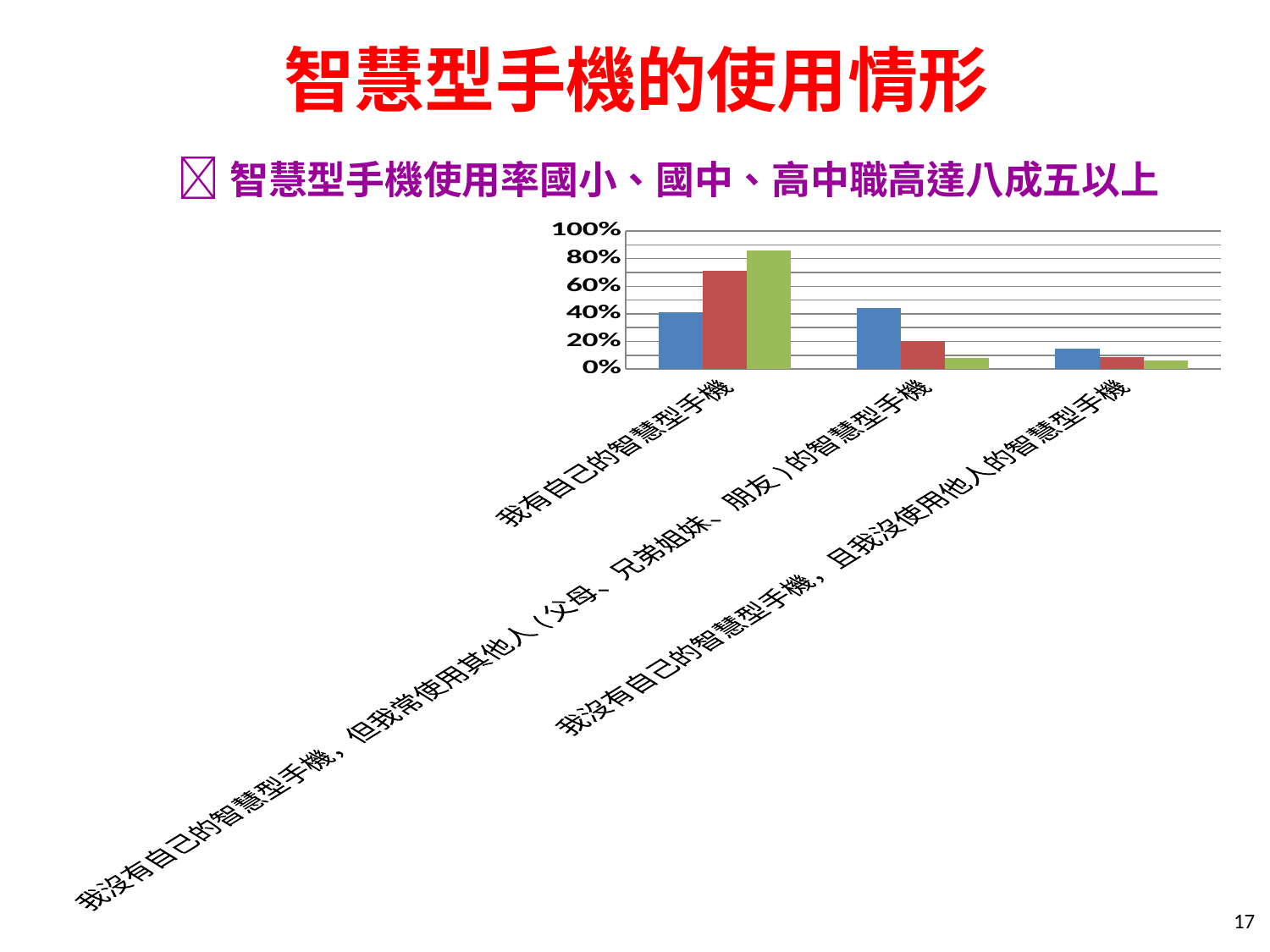
What kind of chart is shown on the slide? bar chart Which colour bar is the highest for 我有自己的智慧型手機? green Is the blue bar for 我沒有自己的智慧型手機，且我沒使用他人的智慧型手機 greater or less than 20%? less For 我有自己的智慧型手機, which bar is taller, the blue bar or the green bar? the green bar For 我沒有自己的智慧型手機，但我常使用其他人（父母、兄弟姐妹、朋友）的智慧型手機, which bar is taller, the blue bar or the green bar? the blue bar How many bars are plotted for each category in the chart? 3 Do the green bars rise or fall from left to right across the three categories? fall Is the red bar for 我有自己的智慧型手機 greater or less than 60%? greater Is the red bar for 我沒有自己的智慧型手機，但我常使用其他人（父母、兄弟姐妹、朋友）的智慧型手機 greater or less than 40%? less How many categories are shown on the x axis of the chart? 3